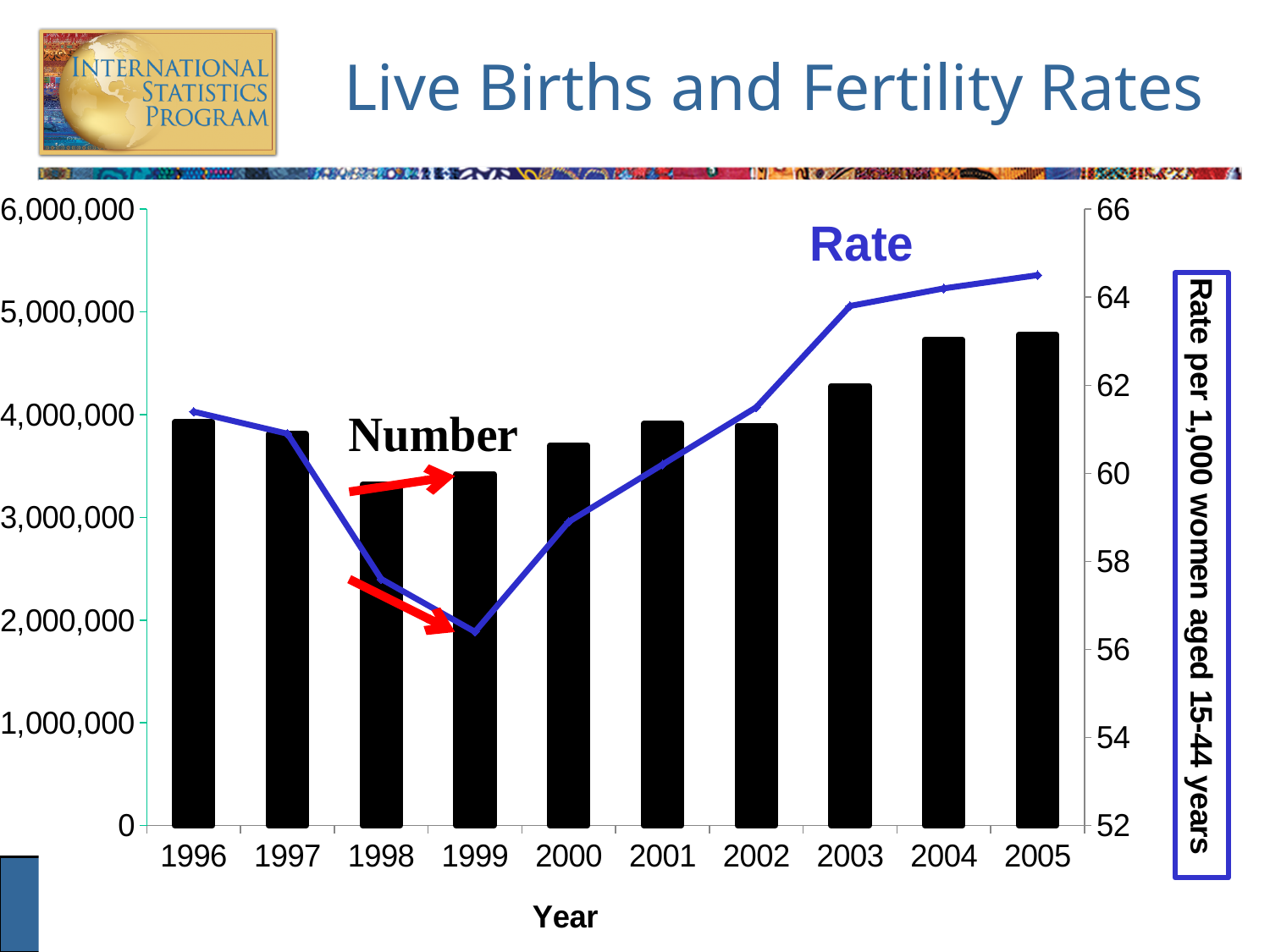
What is the title of the chart on the slide? Live Births and Fertility Rates What kind of chart is shown on the slide? A combined bar and line chart Which year has the larger Number of live births, 1996 or 1998? 1996 How many years are shown along the x axis? 10 What is the label of the right-hand vertical axis? Rate per 1,000 women aged 15-44 years Is the Number of live births in 1998 greater or less than 4,000,000? less In which year is the Rate (line) lowest? 1999 In which year is the Number of live births (bars) lowest? 1998 Does the Rate rise or fall from 1999 to 2005? rise Is the Number of live births in 2004 greater or less than 4,000,000? greater In which year is the Rate (line) highest? 2005 Is the Rate in 1999 greater or less than 58? less